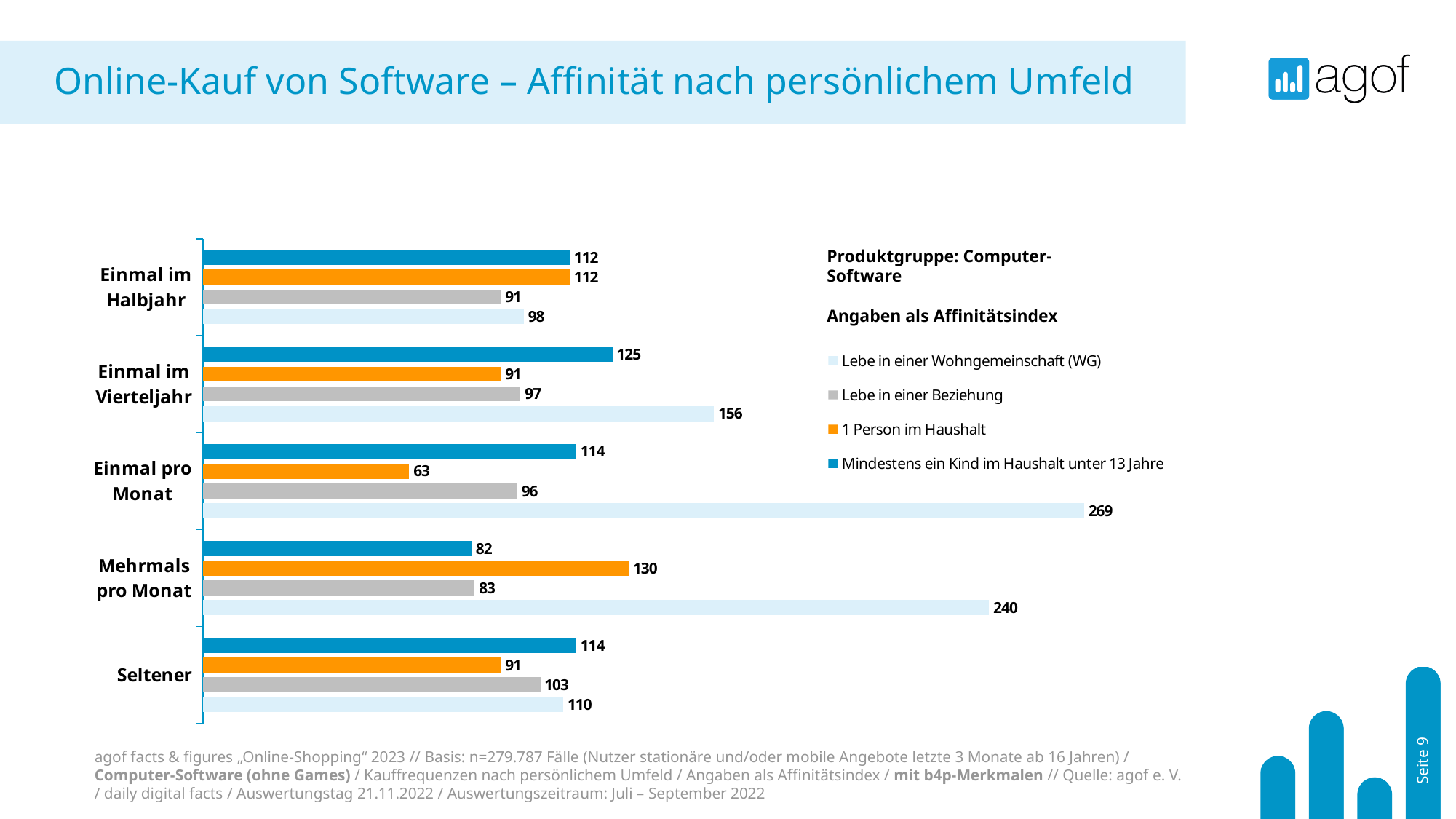
How many categories are shown on the chart? 5 What is the value for "Mindestens ein Kind im Haushalt unter 13 Jahre" in the "Einmal im Vierteljahr" category? 125 Which category has the highest value for "Lebe in einer Wohngemeinschaft (WG)"? Einmal pro Monat How many series does the legend list? 4 What kind of chart is shown on the slide? Bar chart What is the value for "Lebe in einer Beziehung" in the "Seltener" category? 103 Which colour represents "1 Person im Haushalt" in the chart? Orange What is the value for "1 Person im Haushalt" in the "Mehrmals pro Monat" category? 130 What is the affinity index for "Lebe in einer Wohngemeinschaft (WG)" in the "Einmal pro Monat" category? 269 Which is larger in the "Mehrmals pro Monat" category: the value for "1 Person im Haushalt" or for "Mindestens ein Kind im Haushalt unter 13 Jahre"? 1 Person im Haushalt Which category has the lowest value for "1 Person im Haushalt"? Einmal pro Monat What is the difference between the "Lebe in einer Wohngemeinschaft (WG)" values for "Einmal pro Monat" and "Mehrmals pro Monat"? 29